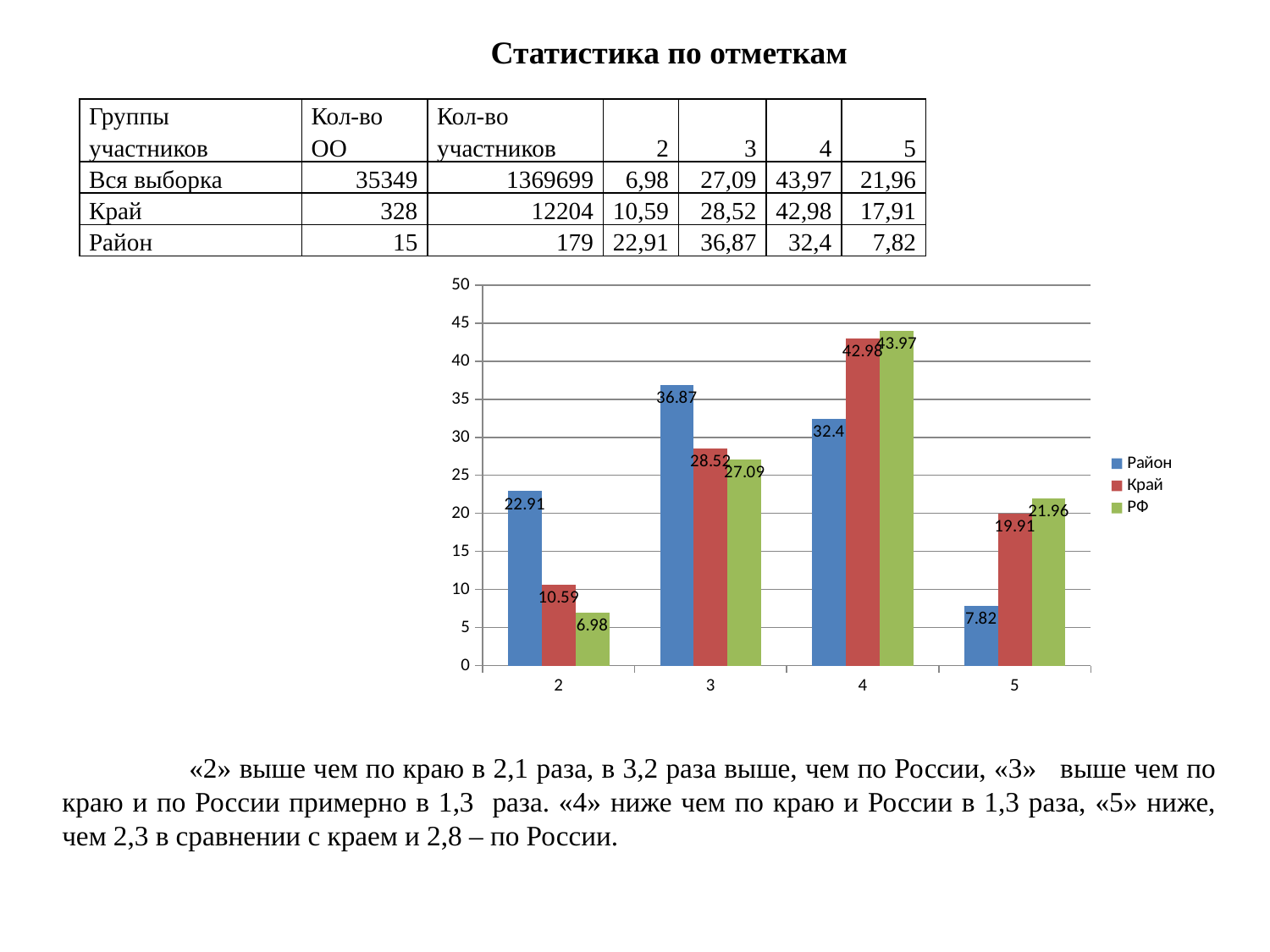
What is the value for Край in category 5? 19.91 In which category is the РФ series lowest? 2 What is the value for РФ in category 4? 43.97 Which series is shown in green in the chart legend? РФ What is the value for Район in category 2? 22.91 Is the value for Край in category 4 greater or less than 40? greater How many series does the chart legend list? 3 In which category is the Район series highest? 3 What type of chart is shown on the slide? bar chart How many categories are shown on the x axis of the chart? 4 What is the difference between the Район and Край values in category 2? 12.32 Which is larger in category 5: the value for Район or the value for РФ? РФ